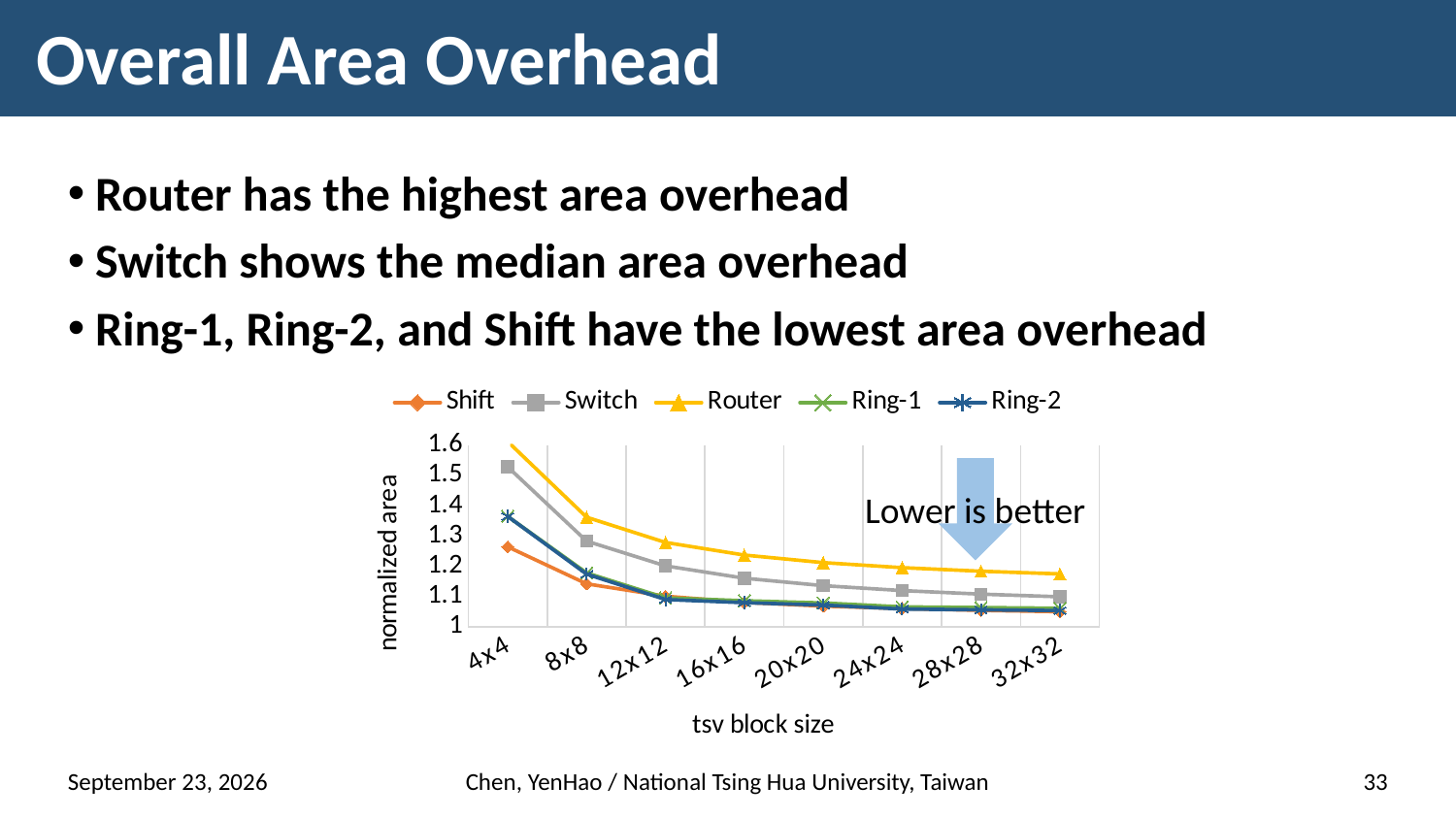
At 8x8, which has the larger normalized area, Switch or Shift? Switch Is the normalized area for Shift at 32x32 greater or less than 1.1? less Which series has the lowest normalized area at 4x4? Shift What kind of chart is shown on the slide? line chart How many series does the chart's legend list? 5 Do the normalized area values rise or fall as the tsv block size increases? fall Is the normalized area for Router at 32x32 greater or less than 1.2? less What is the label of the chart's y axis? normalized area Is the normalized area for Router at 8x8 greater or less than 1.3? greater How many tsv block sizes are plotted along the x axis? 8 Which series has the highest normalized area at 4x4? Router